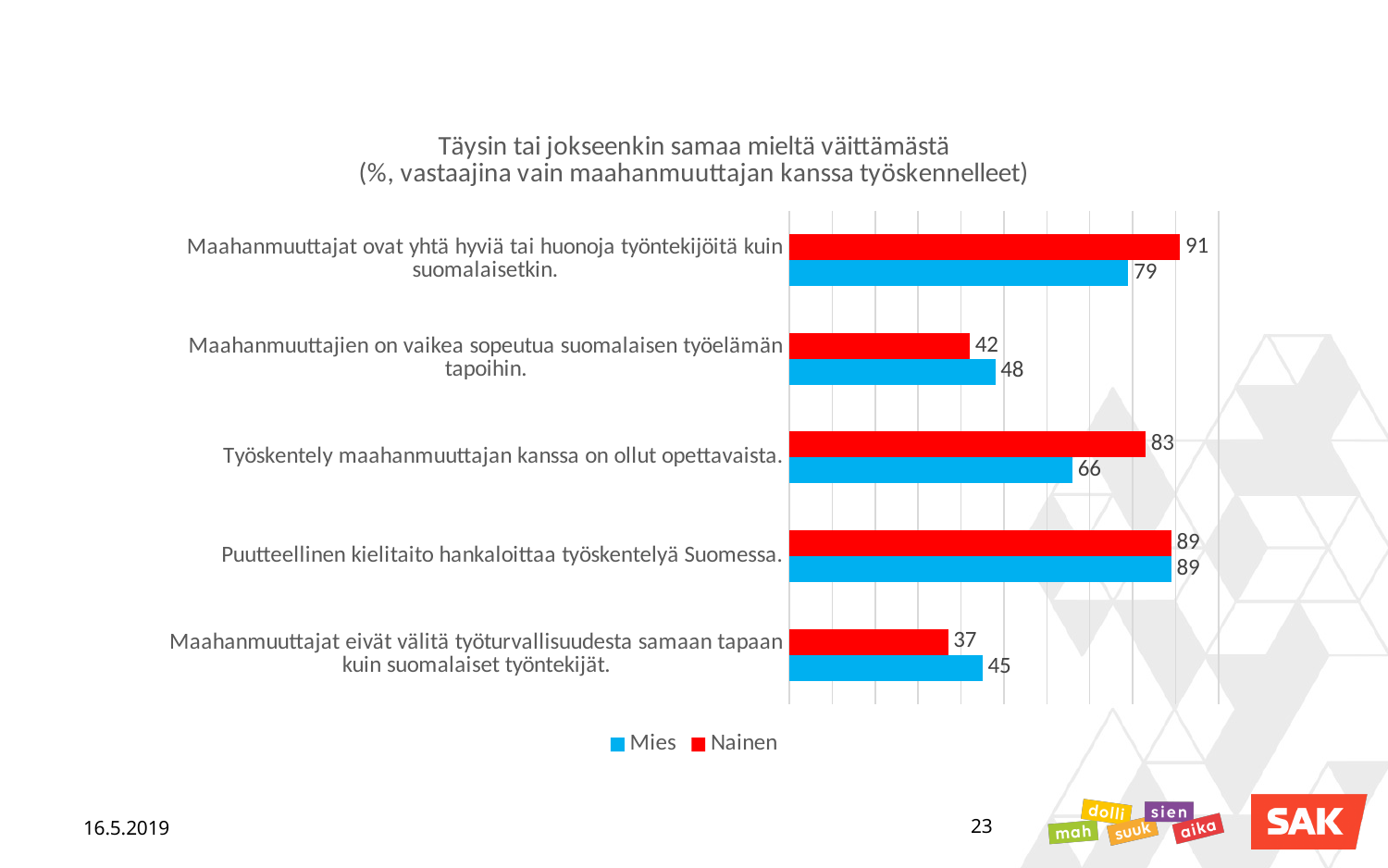
What is the value for Nainen for the statement "Maahanmuuttajat eivät välitä työturvallisuudesta samaan tapaan kuin suomalaiset työntekijät."? 37 Which statement has the lowest value for Nainen? Maahanmuuttajat eivät välitä työturvallisuudesta samaan tapaan kuin suomalaiset työntekijät. For the statement "Maahanmuuttajien on vaikea sopeutua suomalaisen työelämän tapoihin.", which is larger, the Mies value or the Nainen value? Mies What is the value for Nainen for the statement "Maahanmuuttajat ovat yhtä hyviä tai huonoja työntekijöitä kuin suomalaisetkin."? 91 What is the difference between the Nainen and Mies values for "Maahanmuuttajat ovat yhtä hyviä tai huonoja työntekijöitä kuin suomalaisetkin."? 12 What is the value for Mies for the statement "Työskentely maahanmuuttajan kanssa on ollut opettavaista."? 66 How many series does the legend list? 2 Which statement has the highest value for Mies? Puutteellinen kielitaito hankaloittaa työskentelyä Suomessa. How many statements (categories) are shown in the chart? 5 What kind of chart is shown on the slide? Bar chart What is the value for Mies for the statement "Maahanmuuttajien on vaikea sopeutua suomalaisen työelämän tapoihin."? 48 What is the difference between the Nainen and Mies values for "Työskentely maahanmuuttajan kanssa on ollut opettavaista."? 17